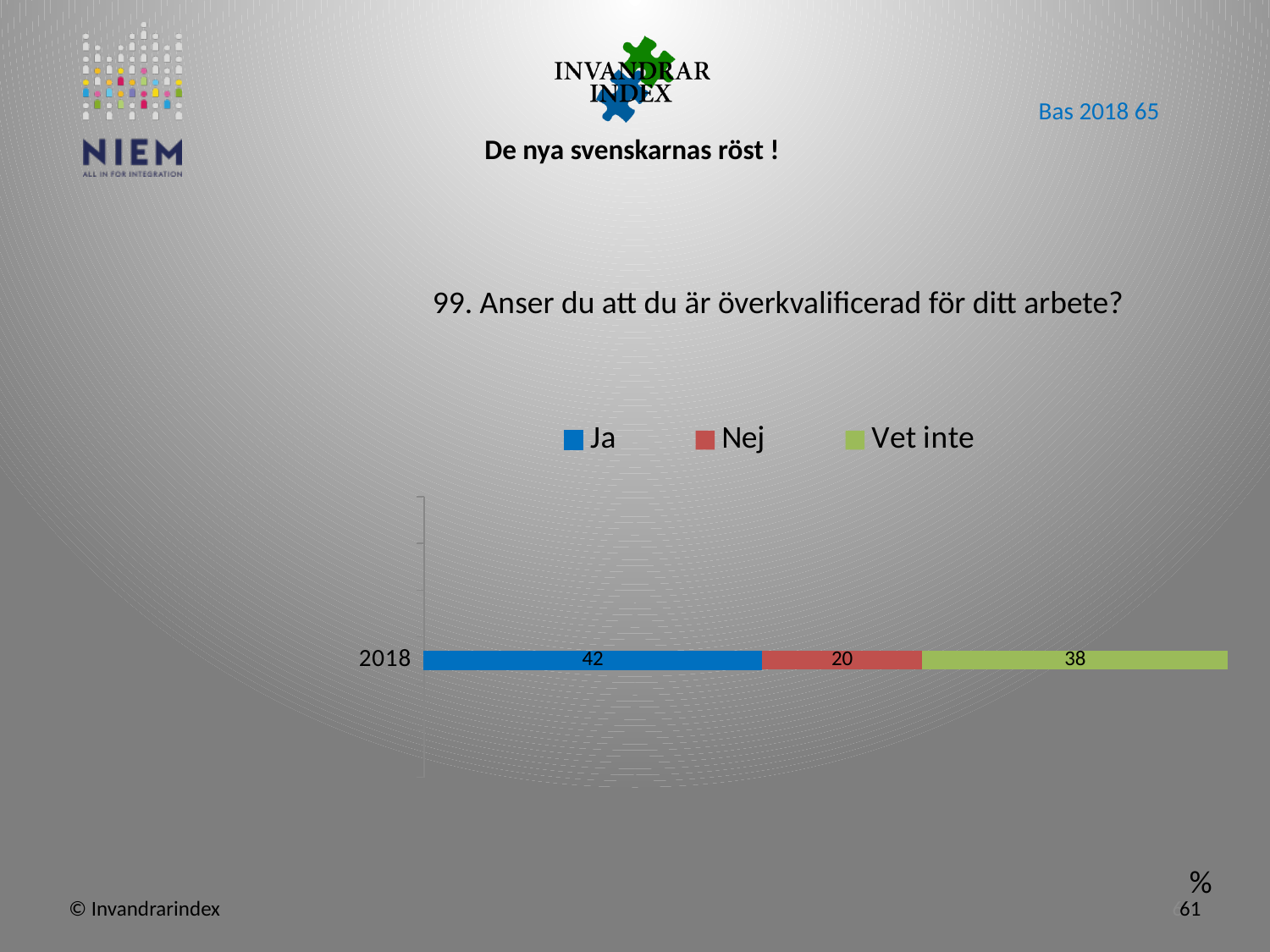
What is the value for Ja in 2018? 42 What is the total of the stacked bar for 2018? 100 Which is larger in 2018, Nej or Vet inte? Vet inte What kind of chart is shown on the slide? Stacked bar chart What is the difference between the Ja and Nej values in 2018? 22 Which series has the lowest value in 2018? Nej What is the value for Nej in 2018? 20 What is the difference between the Ja and Vet inte values in 2018? 4 How many series does the legend list? 3 What is the value for Vet inte in 2018? 38 Which series has the highest value in 2018? Ja How many categories are shown on the chart? 1